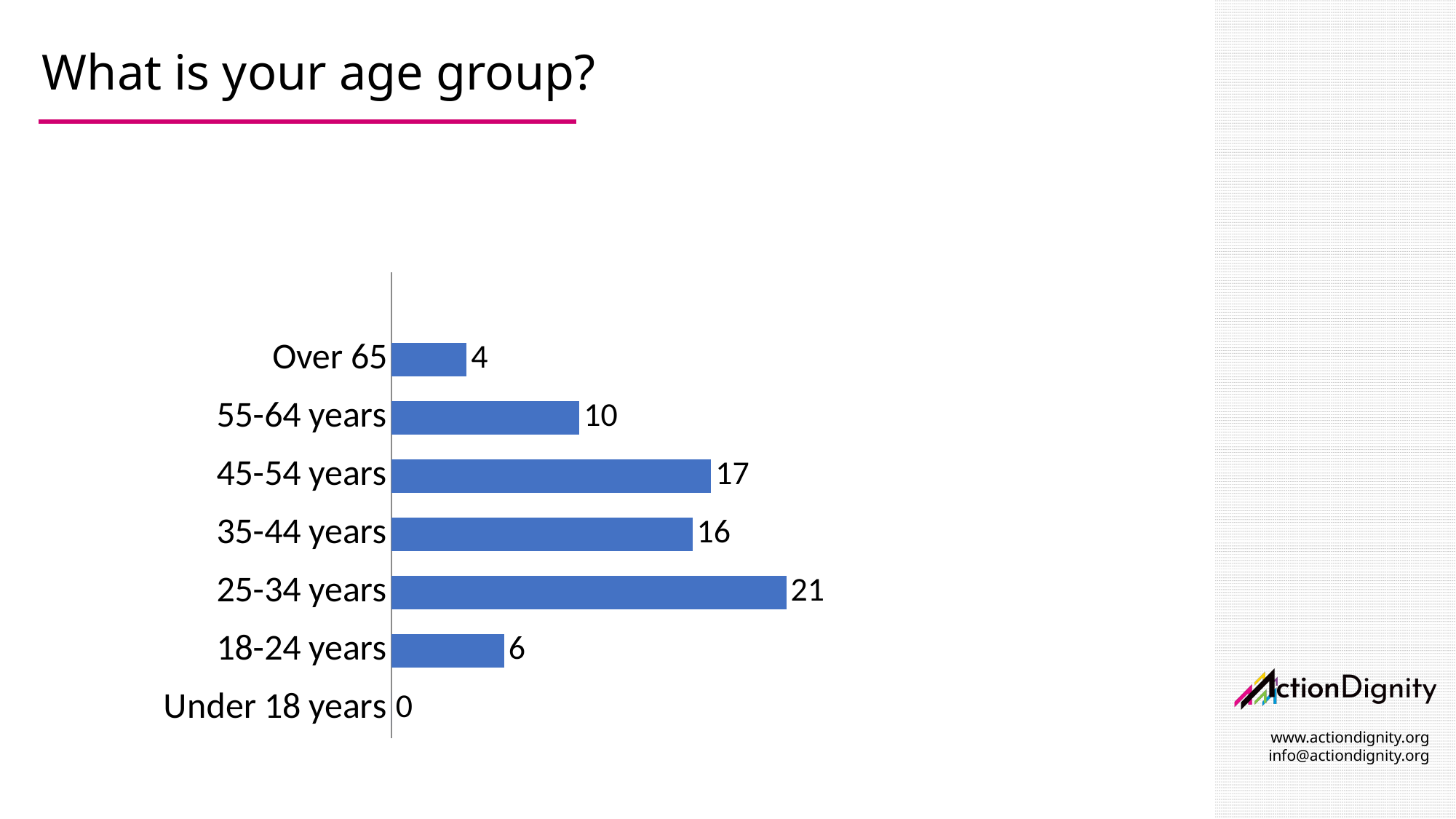
What is the title of the slide? What is your age group? What kind of chart is shown on the slide? Bar chart What is the value for the 55-64 years age group? 10 What colour are the bars in the chart? Blue How many age group categories are shown in the chart? 7 What is the value for the 25-34 years age group? 21 What is the difference between the values for 25-34 years and 18-24 years? 15 What is the value for the Over 65 age group? 4 What is the difference between the values for 45-54 years and 35-44 years? 1 Which age group has the highest value? 25-34 years Which age group has the lowest value? Under 18 years Which is larger, the value for 55-64 years or the value for 18-24 years? 55-64 years